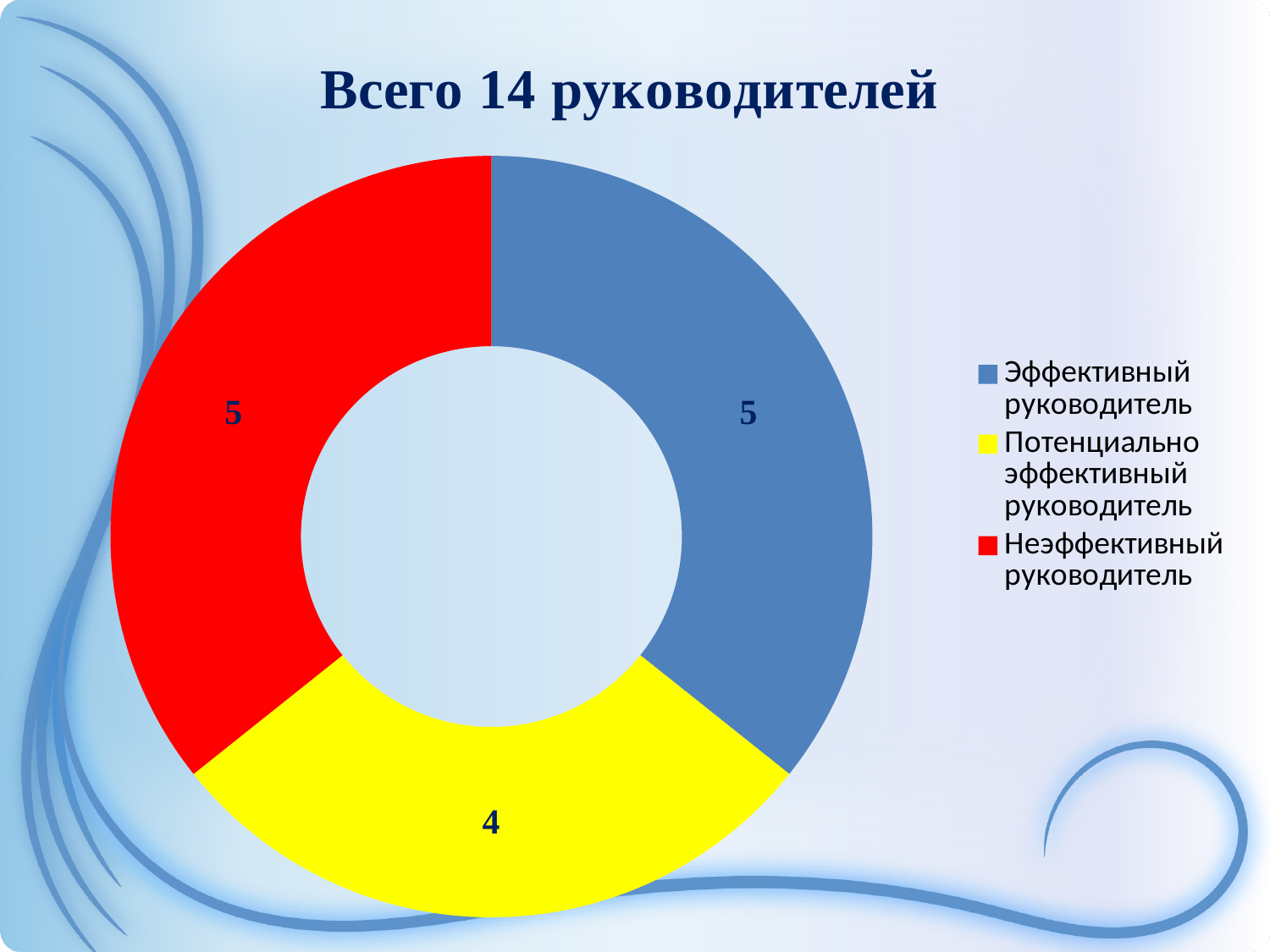
What is the total of all the values shown in the chart? 14 What kind of chart is shown on the slide? Doughnut (pie) chart What is the title of the slide? Всего 14 руководителей What is the difference between the values for Неэффективный руководитель and Потенциально эффективный руководитель? 1 What is the value for Потенциально эффективный руководитель? 4 What colour represents Неэффективный руководитель in the chart? Red Which category has the lowest value? Потенциально эффективный руководитель How many categories does the chart show? 3 What is the value for Неэффективный руководитель? 5 What is the value for Эффективный руководитель? 5 Which is larger: Эффективный руководитель or Потенциально эффективный руководитель? Эффективный руководитель How many entries does the legend list? 3